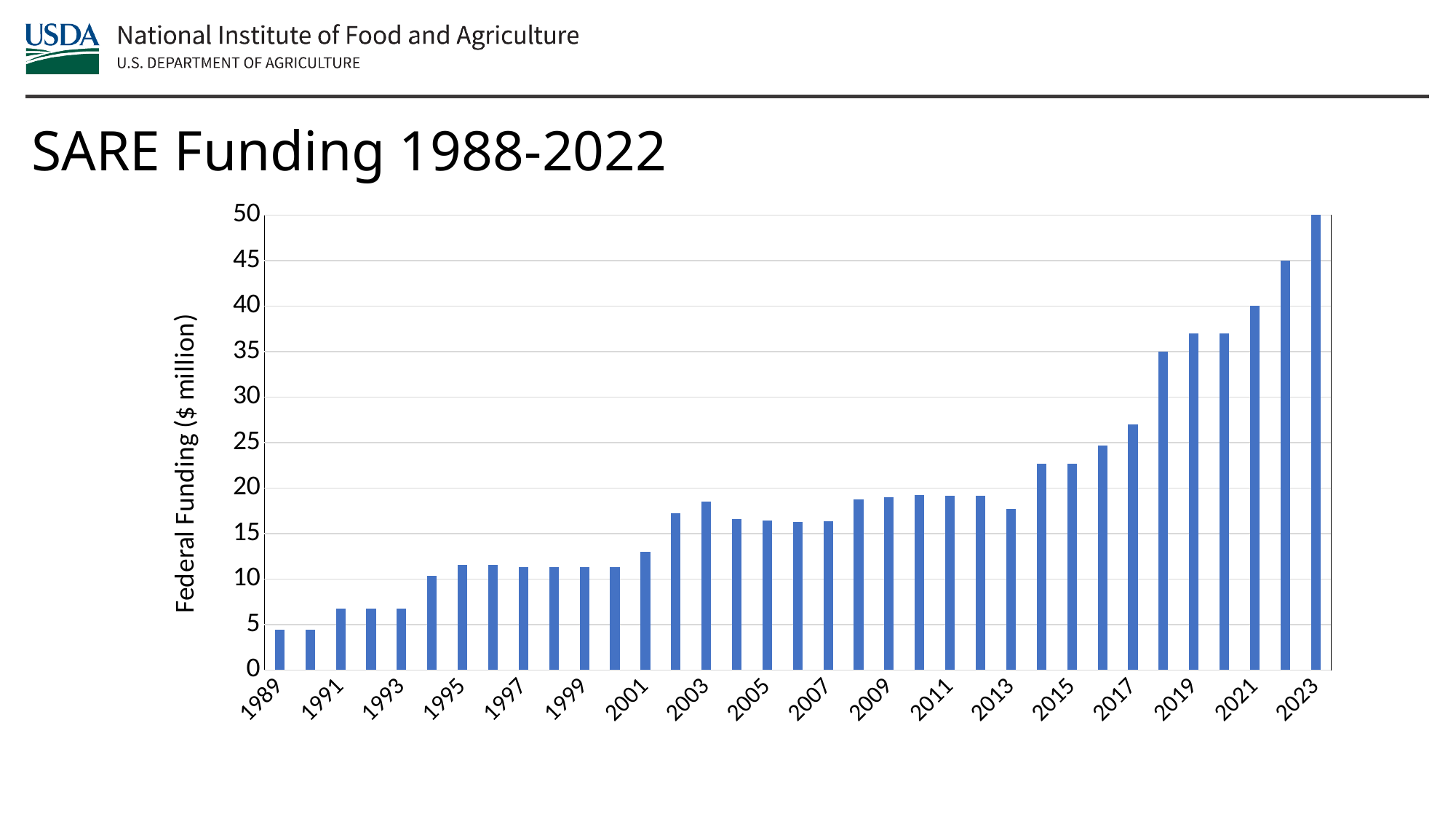
Which year has higher federal funding, 2021 or 2017? 2021 What kind of chart is shown on the slide? bar chart How many bars (years) are plotted in the chart? 35 What is the federal funding value for 2023 in $ million? 50 Is the value for 2003 greater or less than 15? greater What is the label on the vertical axis of the chart? Federal Funding ($ million) Do the funding values generally rise or fall from 1989 to 2023? rise Is the value for 2013 greater or less than 20? less Is the value for 2017 greater or less than 25? greater Which year has the highest federal funding? 2023